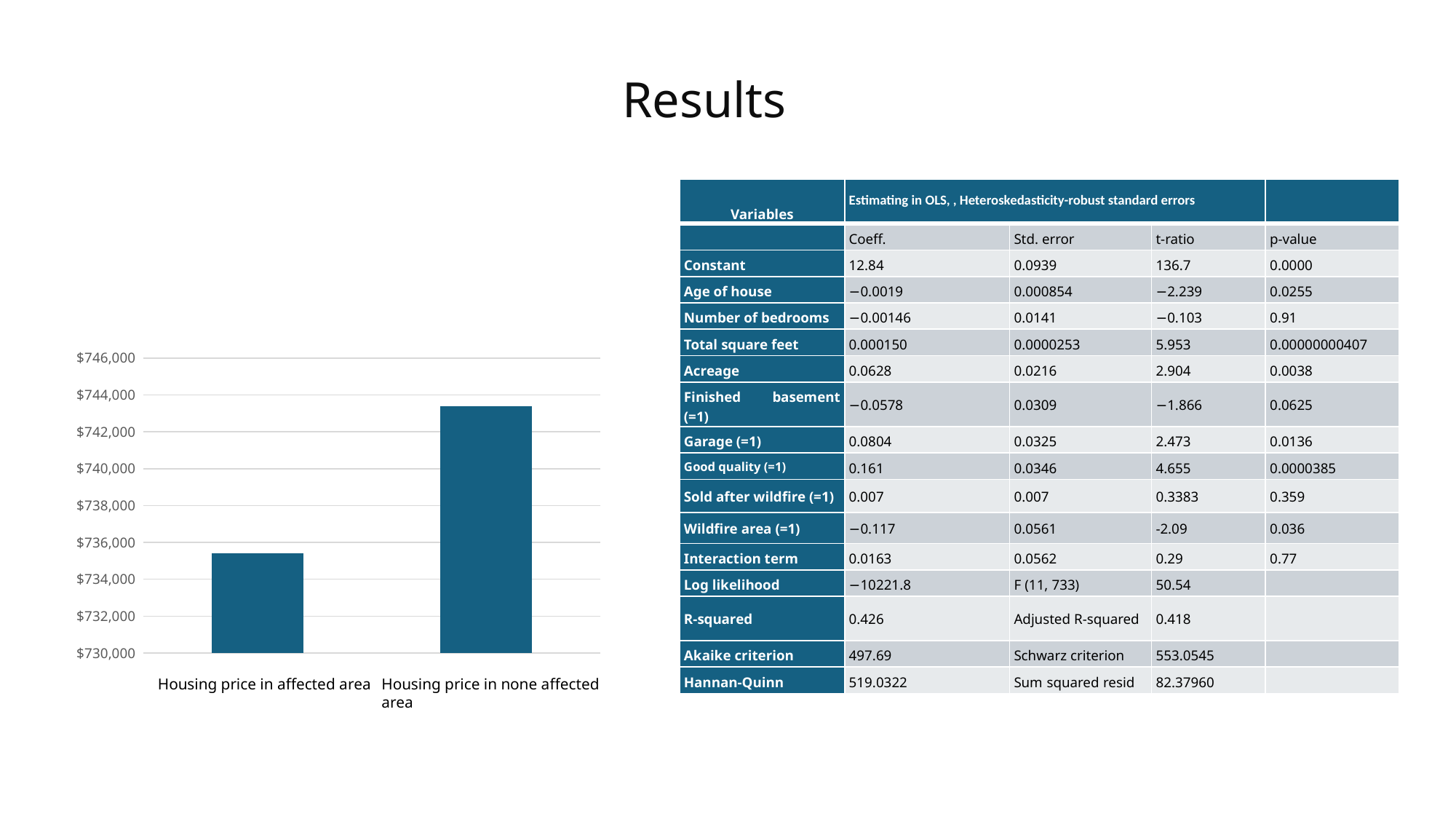
Do the bar values rise or fall from left to right across the chart? rise Is the value for housing price in affected area greater or less than $734,000? greater Which category has the lower bar in the chart? Housing price in affected area Which category has the higher bar in the chart? Housing price in none affected area How many categories does the bar chart show? 2 Is the value for housing price in affected area greater or less than $738,000? less What is the lowest value shown on the chart's vertical axis? $730,000 Is the bar for housing price in the affected area taller or shorter than the bar for housing price in the none affected area? shorter What is the highest value shown on the chart's vertical axis? $746,000 Is the value for housing price in none affected area greater or less than $742,000? greater What kind of chart is shown on the left of the slide? bar chart